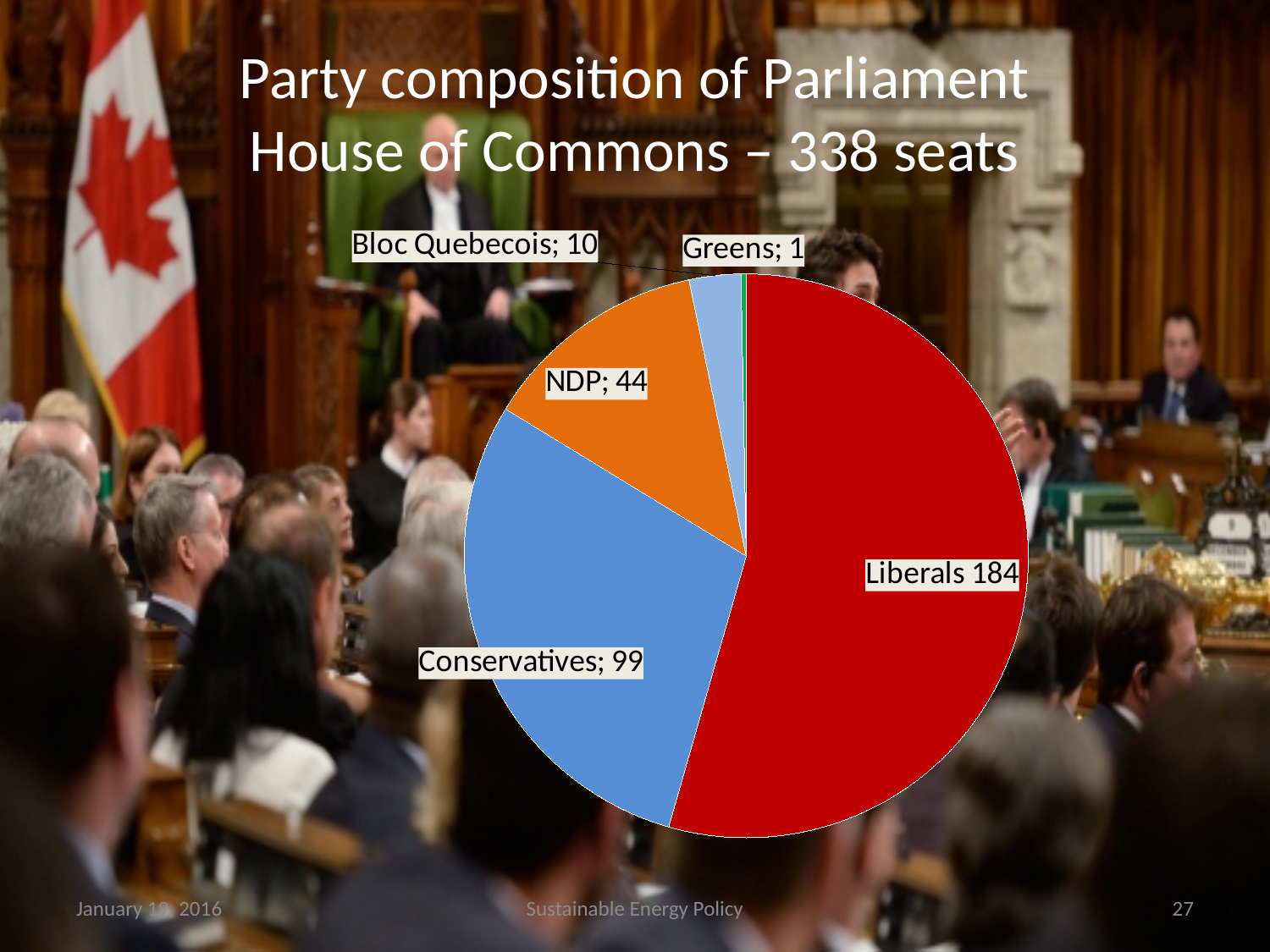
What is the value shown for the NDP slice? 44 How many seats are shown for the Bloc Quebecois? 10 What is the difference in seats between the Liberals and the Conservatives? 85 What kind of chart is shown on the slide? Pie chart Which party has the largest slice of the pie chart? Liberals How many seats does the pie chart show for the Greens? 1 Which party has the smallest slice of the pie chart? Greens What share of the 338 seats do the Liberals hold, to one decimal place? 54.4% How many seats does the pie chart show for the Conservatives? 99 How many parties are shown in the pie chart? 5 How many seats do the Liberals hold according to the pie chart? 184 Which party has more seats, the NDP or the Bloc Quebecois? NDP